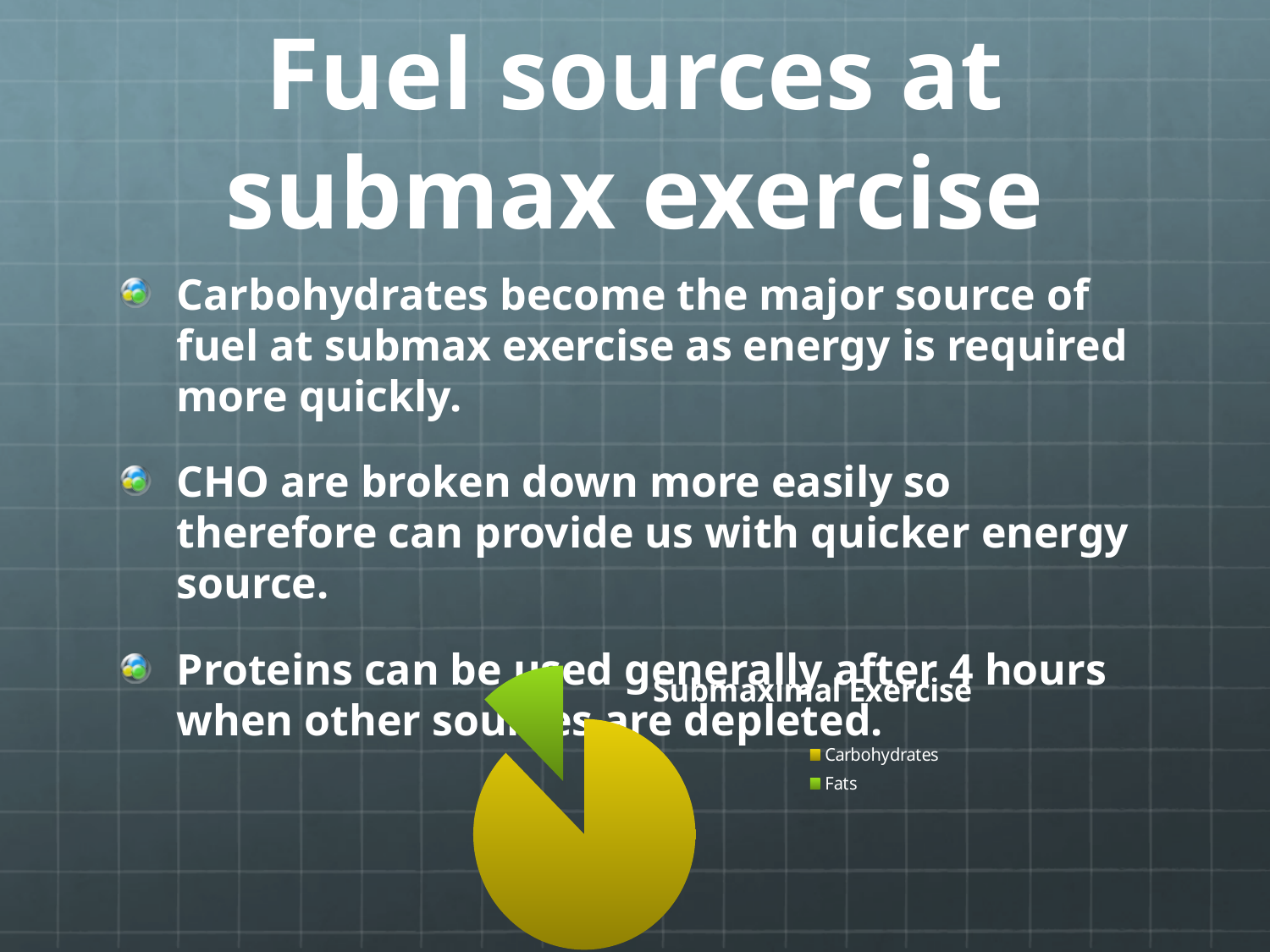
Which category has the smallest slice in the pie chart? Fats How many categories does the pie chart's legend list? 2 Which category is shown in yellow in the pie chart? Carbohydrates What is the title of the pie chart? Submaximal Exercise What colour is the Fats slice in the pie chart? green In the pie chart, which slice is larger, Carbohydrates or Fats? Carbohydrates What kind of chart is shown on the slide? pie chart Which category has the largest slice in the pie chart? Carbohydrates